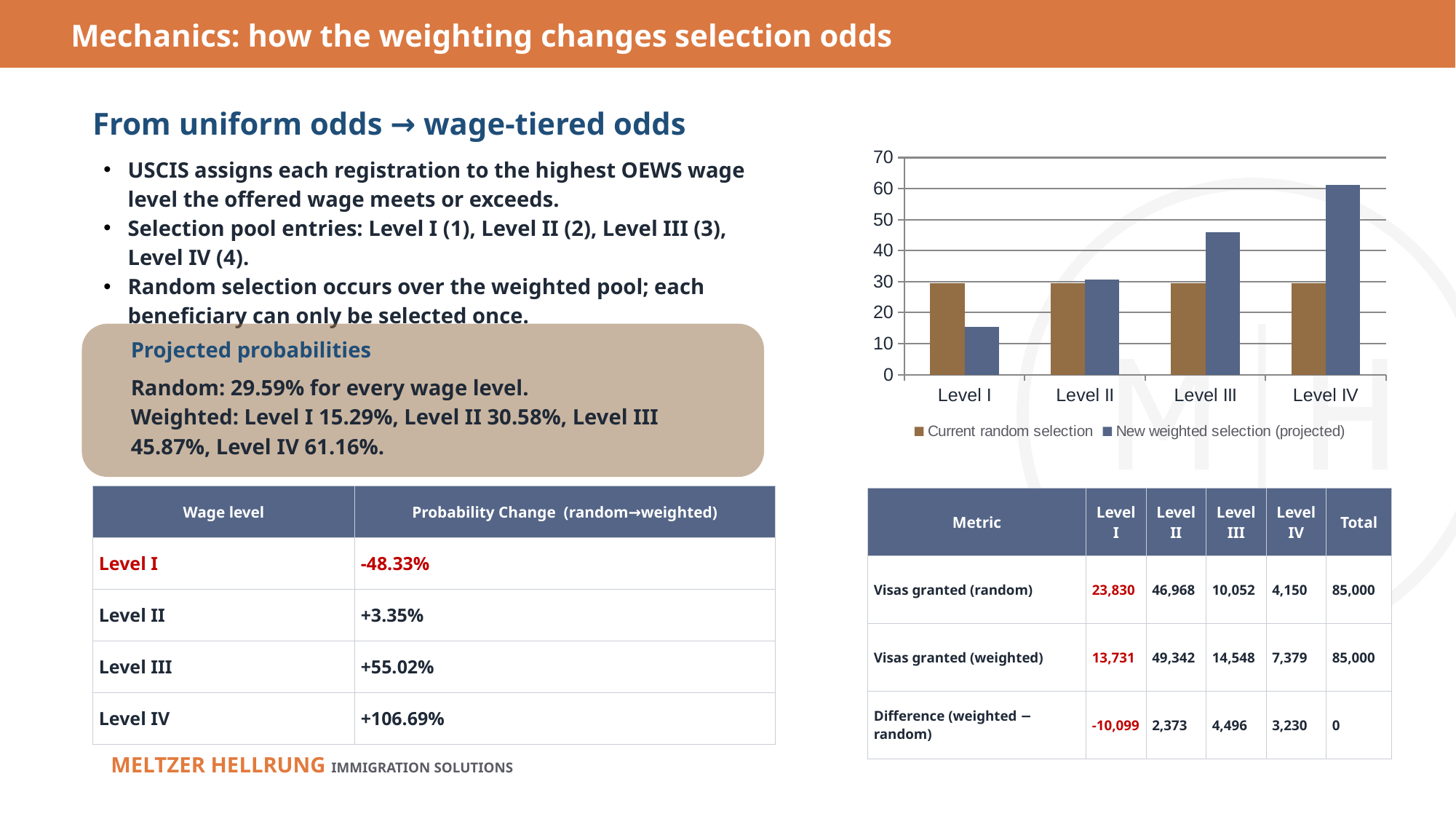
How many wage level categories are shown on the chart's x axis? 4 Which wage level has the highest value for New weighted selection (projected)? Level IV Is the New weighted selection (projected) value for Level I greater or less than 20? less Which wage level has the lowest value for New weighted selection (projected)? Level I What are the two legend entries of the chart? Current random selection; New weighted selection (projected) Is the New weighted selection (projected) value for Level III greater or less than 40? greater For Level I, which is larger: Current random selection or New weighted selection (projected)? Current random selection What kind of chart is shown on the slide? bar chart For Level III, which is larger: Current random selection or New weighted selection (projected)? New weighted selection (projected) Is the New weighted selection (projected) value for Level IV greater or less than 60? greater Do the New weighted selection (projected) values rise or fall from Level I to Level IV? rise How many series does the chart's legend list? 2